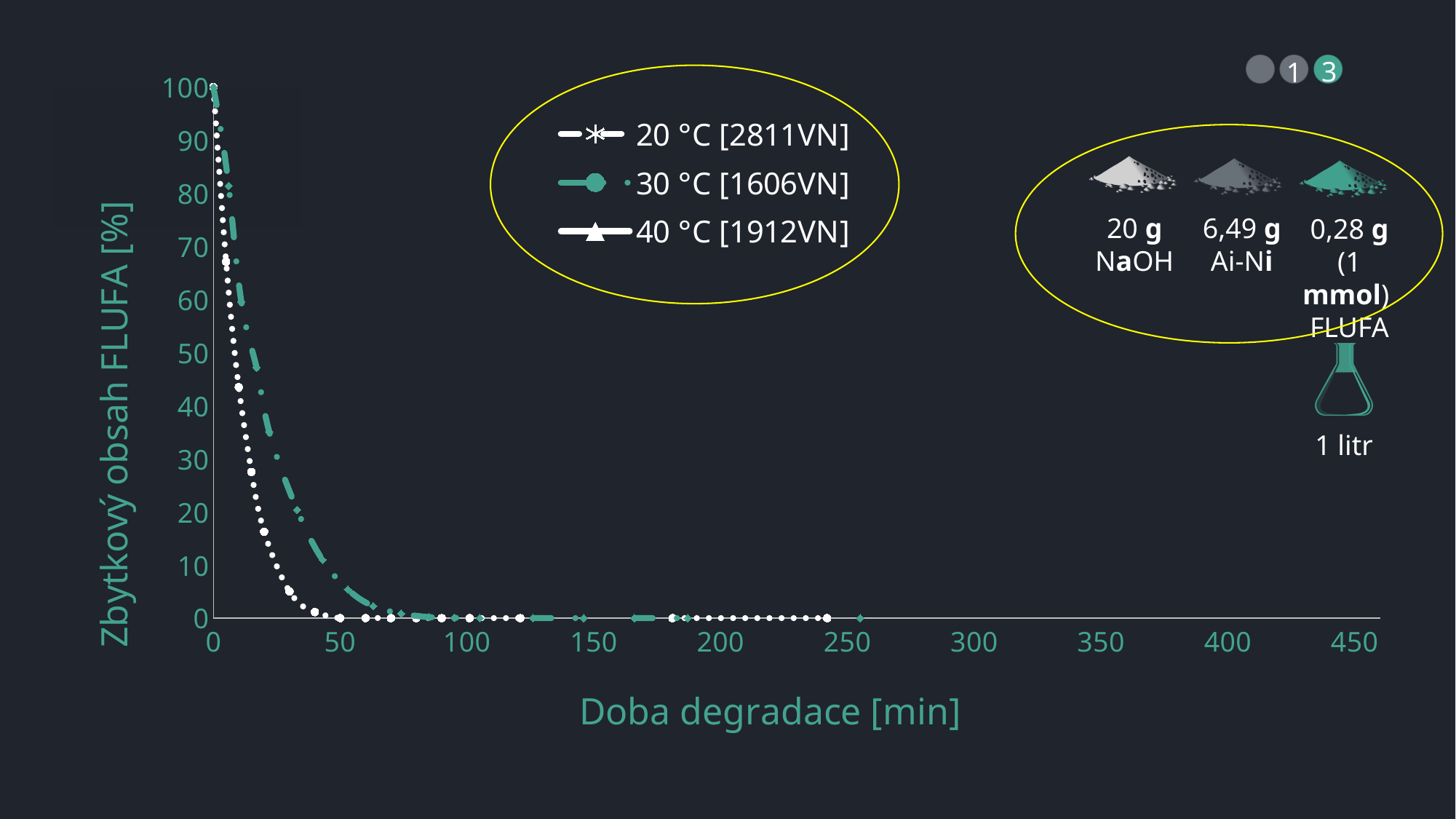
At 30 min, which series has the higher residual FLUFA content, 20 °C [2811VN] or 30 °C [1606VN]? 30 °C [1606VN] Is the value for the 30 °C [1606VN] series at 100 min greater or less than 10? less What kind of chart is shown on the slide? line chart Do the values of the 30 °C [1606VN] series rise or fall as degradation time increases? fall How many series does the chart legend list? 3 What is the title of the x axis? Doba degradace [min] Is the value for the 30 °C [1606VN] series at 25 min greater or less than 60? less What colour is the 30 °C [1606VN] series drawn in? green What is the residual FLUFA content at 0 min for the 20 °C [2811VN] series? 100 Is the value for the 20 °C [2811VN] series at 10 min greater or less than 30? greater